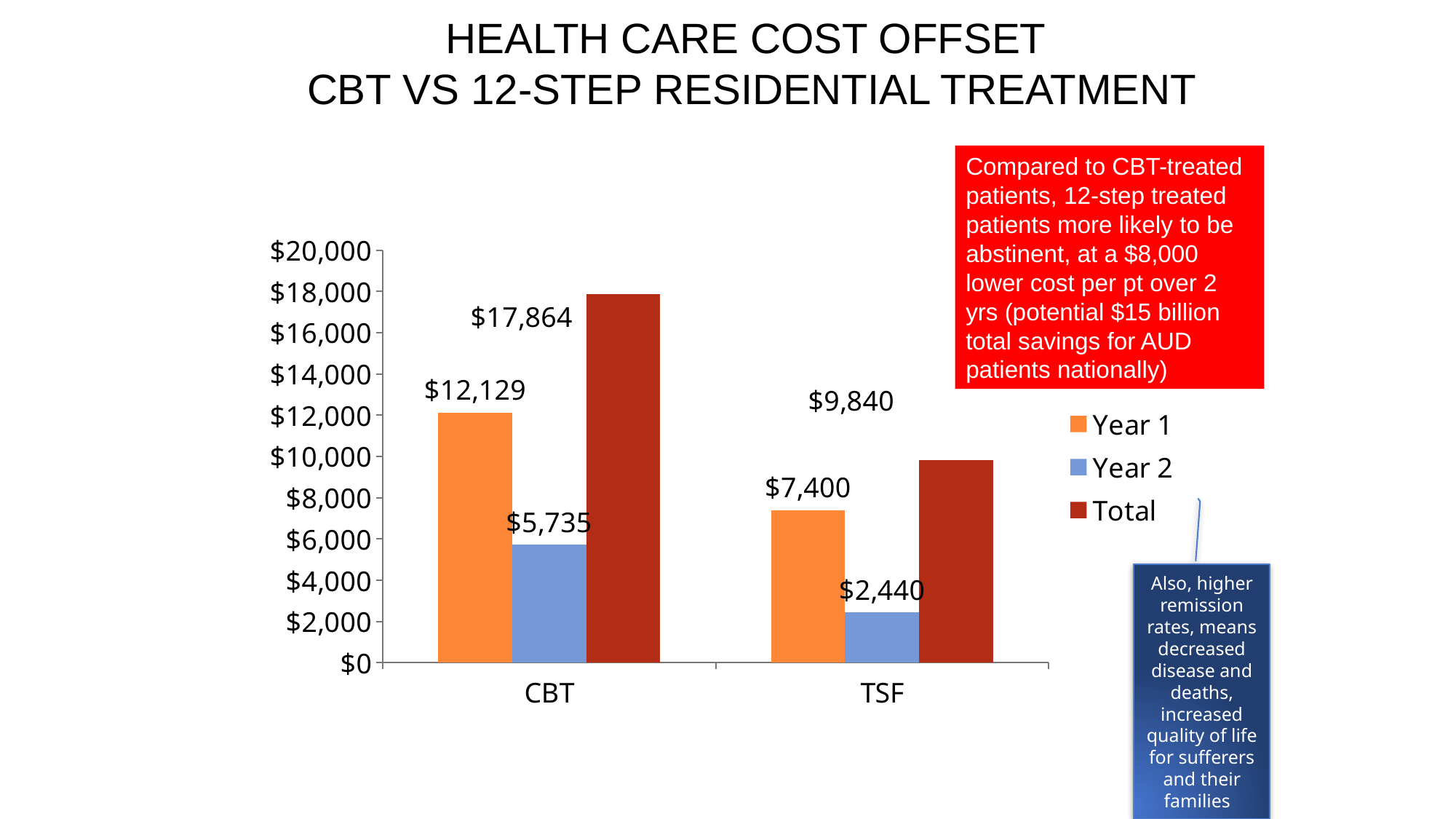
What is the Year 2 value for TSF? $2,440 What is the Year 1 value for CBT? $12,129 What is the Total value for CBT? $17,864 Is the Year 2 value for CBT greater or less than $6,000? less Which series has the lowest value for TSF? Year 2 What is the difference between the Year 1 values for CBT and TSF? $4,729 How many series does the legend list? 3 What kind of chart is shown on the slide? bar chart What is the Total value for TSF? $9,840 Which category has the higher Total value, CBT or TSF? CBT What is the difference between the Total values for CBT and TSF? $8,024 How many categories are shown on the x axis? 2